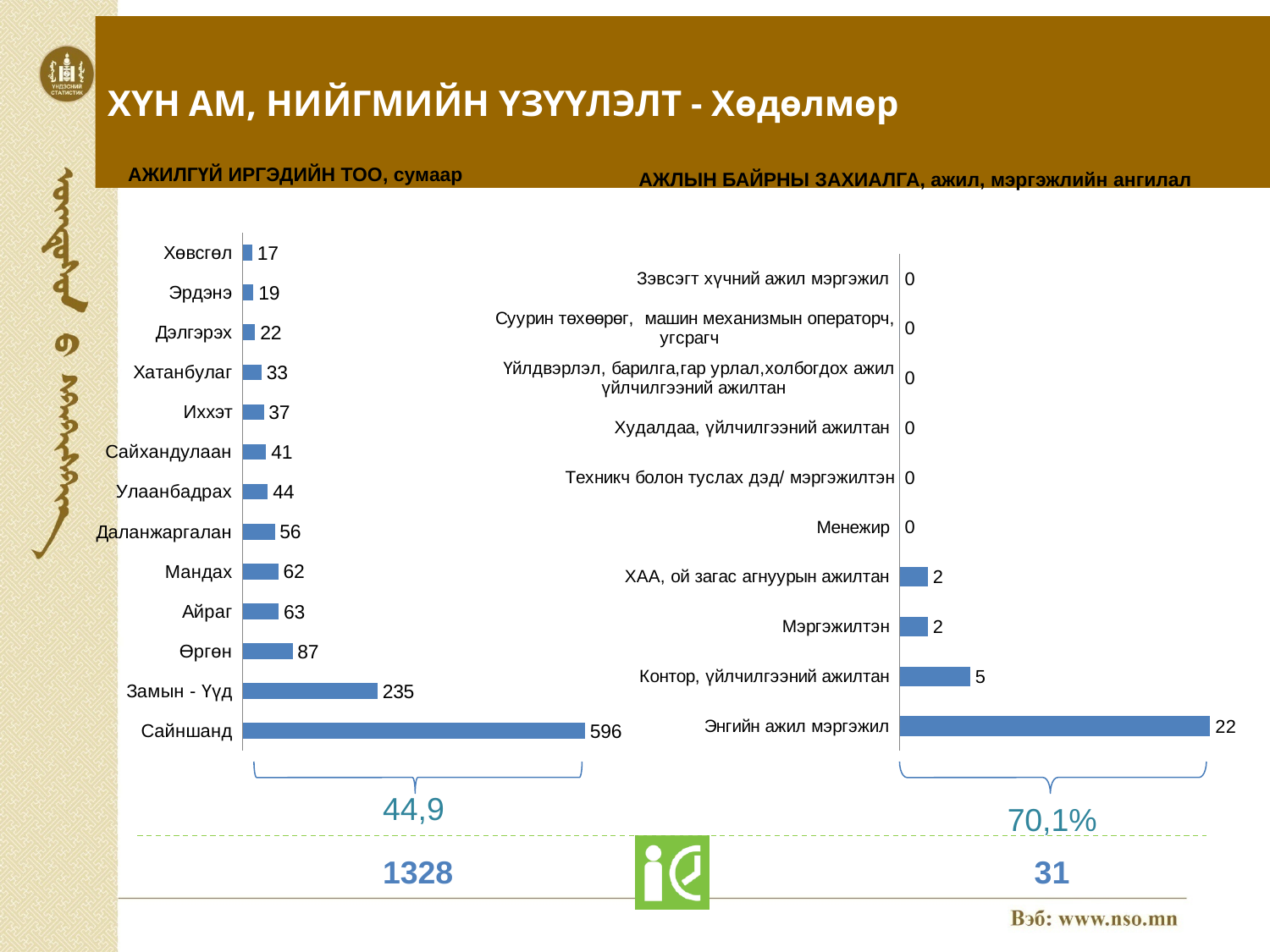
In the chart titled 'АЖИЛГҮЙ ИРГЭДИЙН ТОО, сумаар', what is the value for Замын - Үүд? 235 In the chart titled 'АЖИЛГҮЙ ИРГЭДИЙН ТОО, сумаар', which category has the lowest value? Хөвсгөл What kind of chart is the chart titled 'АЖИЛГҮЙ ИРГЭДИЙН ТОО, сумаар'? Bar chart How many categories are shown in the chart titled 'АЖИЛГҮЙ ИРГЭДИЙН ТОО, сумаар'? 13 In the chart titled 'АЖЛЫН БАЙРНЫ ЗАХИАЛГА, ажил, мэргэжлийн ангилал', what is the difference between the values for Энгийн ажил мэргэжил and Контор, үйлчилгээний ажилтан? 17 In the chart titled 'АЖИЛГҮЙ ИРГЭДИЙН ТОО, сумаар', which is larger, the value for Мандах or the value for Айраг? Айраг In the chart titled 'АЖИЛГҮЙ ИРГЭДИЙН ТОО, сумаар', what is the value for Сайншанд? 596 In the chart titled 'АЖЛЫН БАЙРНЫ ЗАХИАЛГА, ажил, мэргэжлийн ангилал', what is the value for Энгийн ажил мэргэжил? 22 In the chart titled 'АЖЛЫН БАЙРНЫ ЗАХИАЛГА, ажил, мэргэжлийн ангилал', which category has the highest value? Энгийн ажил мэргэжил In the chart titled 'АЖИЛГҮЙ ИРГЭДИЙН ТОО, сумаар', what is the difference between the values for Сайншанд and Замын - Үүд? 361 In the chart titled 'АЖЛЫН БАЙРНЫ ЗАХИАЛГА, ажил, мэргэжлийн ангилал', what is the value for Контор, үйлчилгээний ажилтан? 5 How many categories are shown in the chart titled 'АЖЛЫН БАЙРНЫ ЗАХИАЛГА, ажил, мэргэжлийн ангилал'? 10